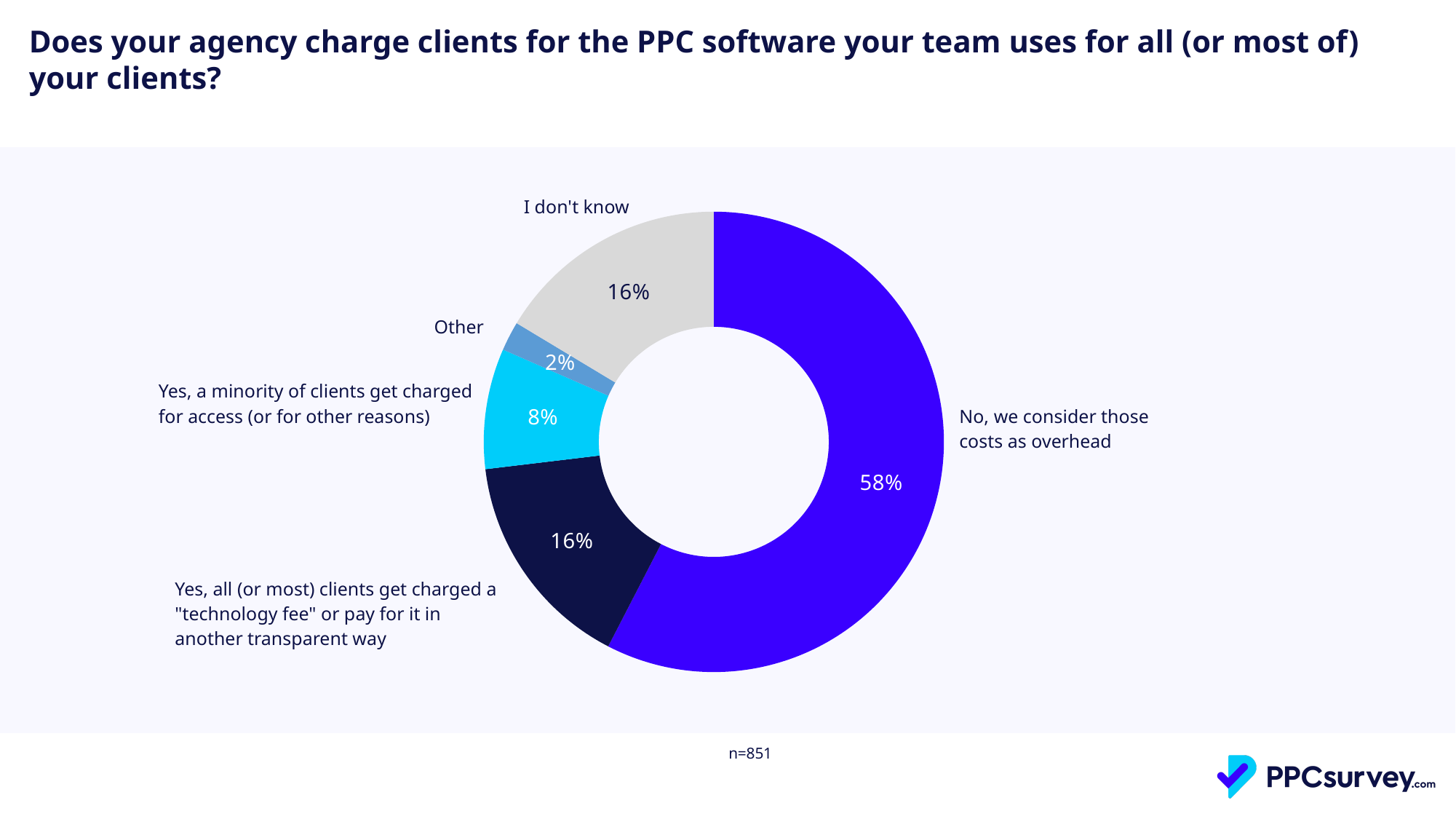
How many response categories are shown in the chart? 5 What percentage of respondents said "I don't know"? 16% What kind of chart is shown on the slide? Pie chart (donut) Which response has the largest share of the pie? No, we consider those costs as overhead What percentage said a minority of clients get charged for access (or for other reasons)? 8% What is the sample size (n) shown below the chart? n=851 Which is larger: the share for "Yes, a minority of clients get charged for access" or the share for "Other"? Yes, a minority of clients get charged for access (or for other reasons) What is the difference in percentage points between "No, we consider those costs as overhead" and "I don't know"? 42 Which response has the smallest share of the pie? Other What share of respondents chose "Other"? 2% What percentage said all (or most) clients get charged a "technology fee" or pay for it in another transparent way? 16% What share of respondents answered "No, we consider those costs as overhead"? 58%